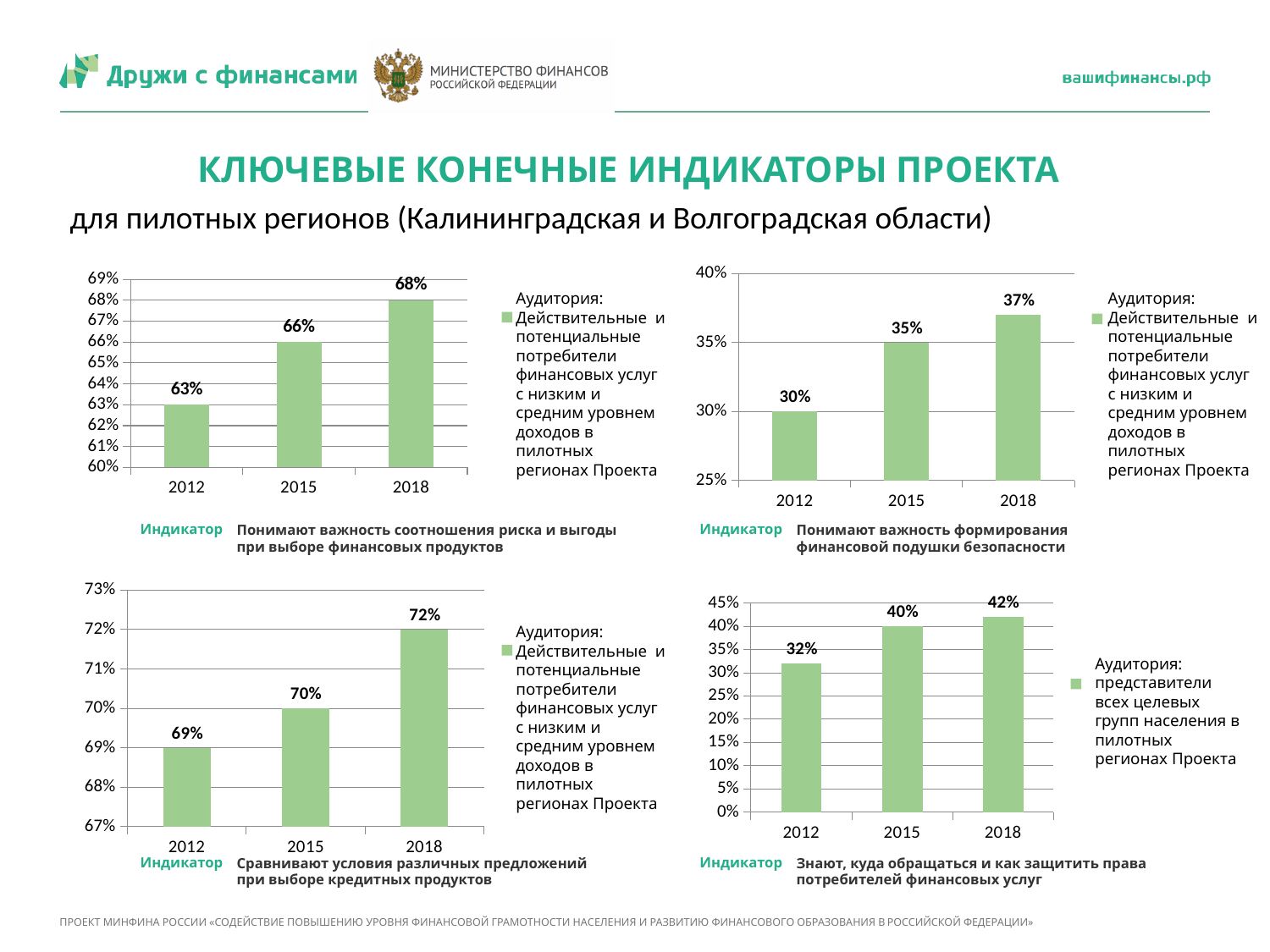
In the top-left chart, what is the difference between the 2018 and 2012 values? 5% In the bottom-right chart, what is the difference between the 2015 and 2012 values? 8% In the bottom-left chart, which is larger: the value for 2012 or the value for 2018? 2018 In the top-left chart (indicator 'Понимают важность соотношения риска и выгоды при выборе финансовых продуктов'), what is the value for 2018? 68% In the bottom-left chart (indicator 'Сравнивают условия различных предложений при выборе кредитных продуктов'), what is the value for 2015? 70% In the top-right chart (indicator 'Понимают важность формирования финансовой подушки безопасности'), what is the value for 2012? 30% How many years (categories) are shown on the x axis of the top-right chart? 3 What kind of chart is the bottom-left chart? Bar chart In the top-right chart, do the values rise or fall from 2012 to 2018? Rise In the top-right chart, which year has the lowest value? 2012 In the bottom-right chart, which year has the highest value? 2018 In the bottom-right chart (indicator 'Знают, куда обращаться и как защитить права потребителей финансовых услуг'), what is the value for 2012? 32%